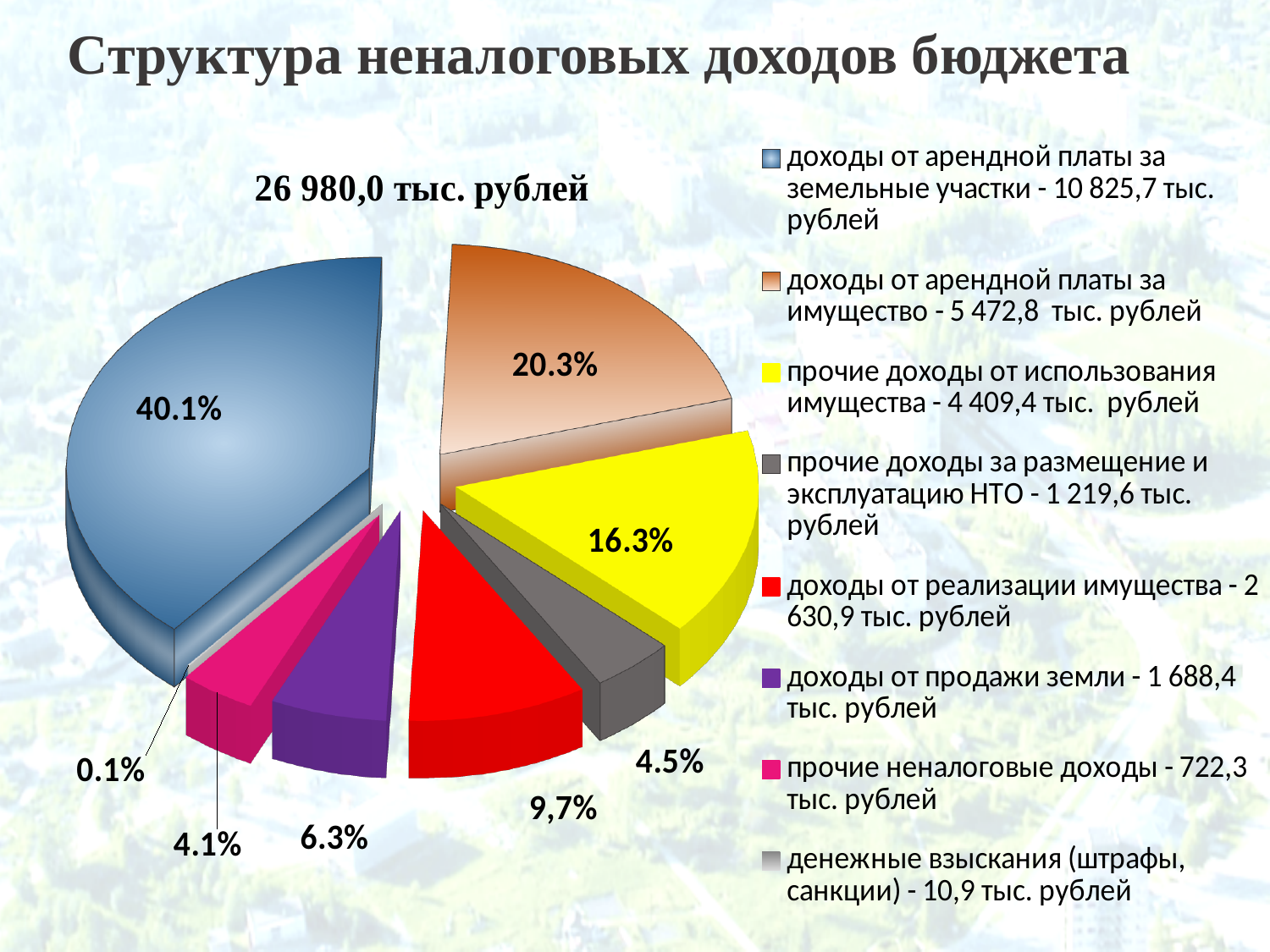
According to the legend, what is the value for прочие доходы за размещение и эксплуатацию НТО? 1 219,6 тыс. рублей What is the difference in percentage points between the blue slice (40.1%) and the orange slice (20.3%)? 19.8 What kind of chart is shown on the slide? pie chart Which is larger: the share for доходы от арендной платы за имущество or the share for прочие доходы от использования имущества? доходы от арендной платы за имущество What percentage is shown on the yellow slice (прочие доходы от использования имущества)? 16.3% How many categories does the legend of the pie chart list? 8 Which category has the smallest share of the pie? денежные взыскания (штрафы, санкции) What share of the pie is labelled for the blue slice (доходы от арендной платы за земельные участки)? 40.1% What percentage is shown on the red slice (доходы от реализации имущества)? 9,7% What is the title of the slide's chart? 26 980,0 тыс. рублей According to the legend, what is the value for доходы от продажи земли? 1 688,4 тыс. рублей Which category has the largest share of the pie? доходы от арендной платы за земельные участки